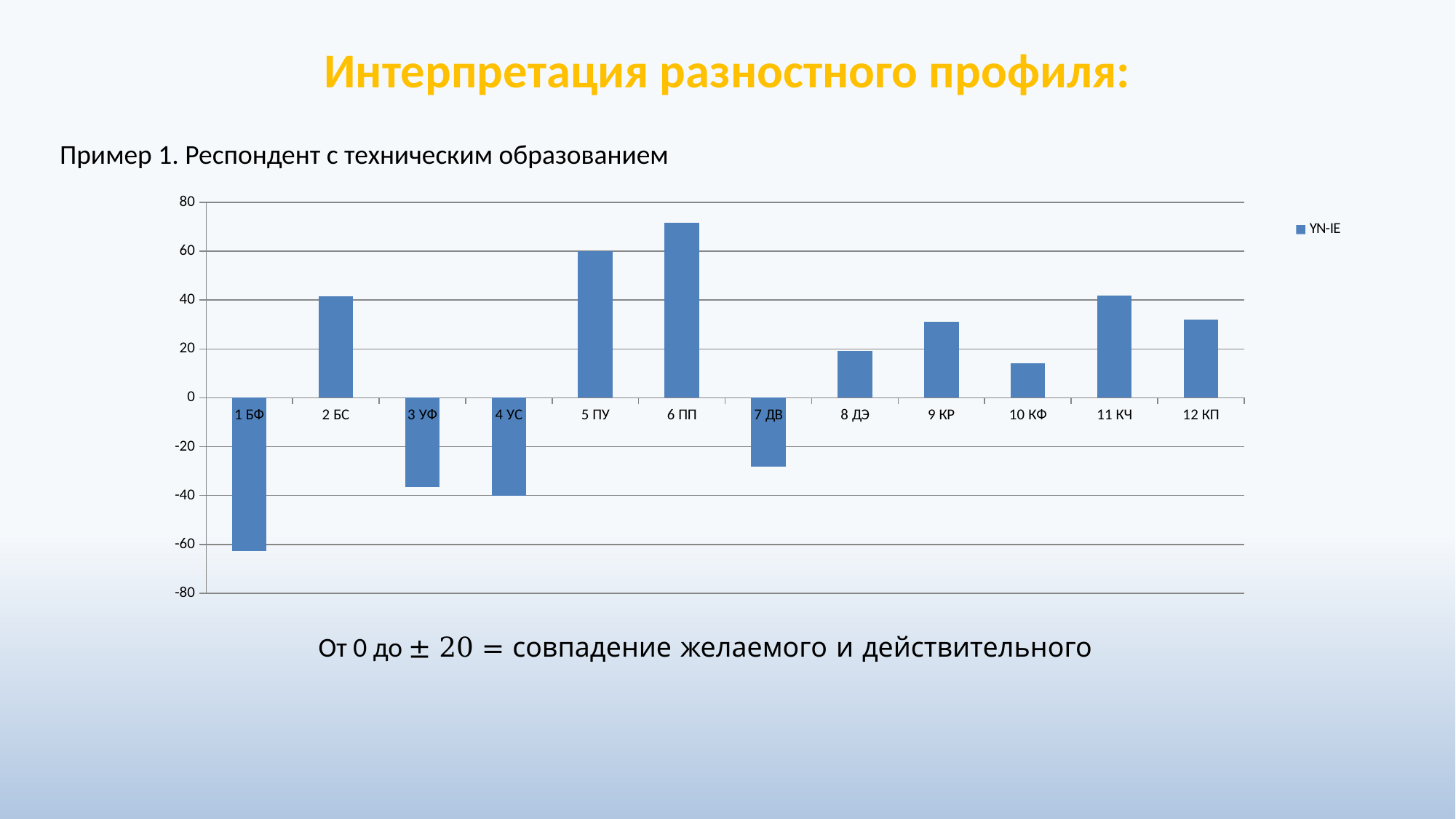
Which category has the lowest value in the chart? 1 БФ Is the value for 7 ДВ greater or less than -20? less How many series does the chart's legend list? 1 Which is larger, the value for 6 ПП or the value for 5 ПУ? 6 ПП Is the value for 10 КФ greater or less than 20? less What kind of chart is shown on the slide? bar chart What is the name of the series shown in the chart's legend? YN-IE Is the value for 6 ПП greater or less than 60? greater How many categories are plotted on the x axis of the chart? 12 Which category has the highest value in the chart? 6 ПП Which is larger, the value for 9 КР or the value for 10 КФ? 9 КР